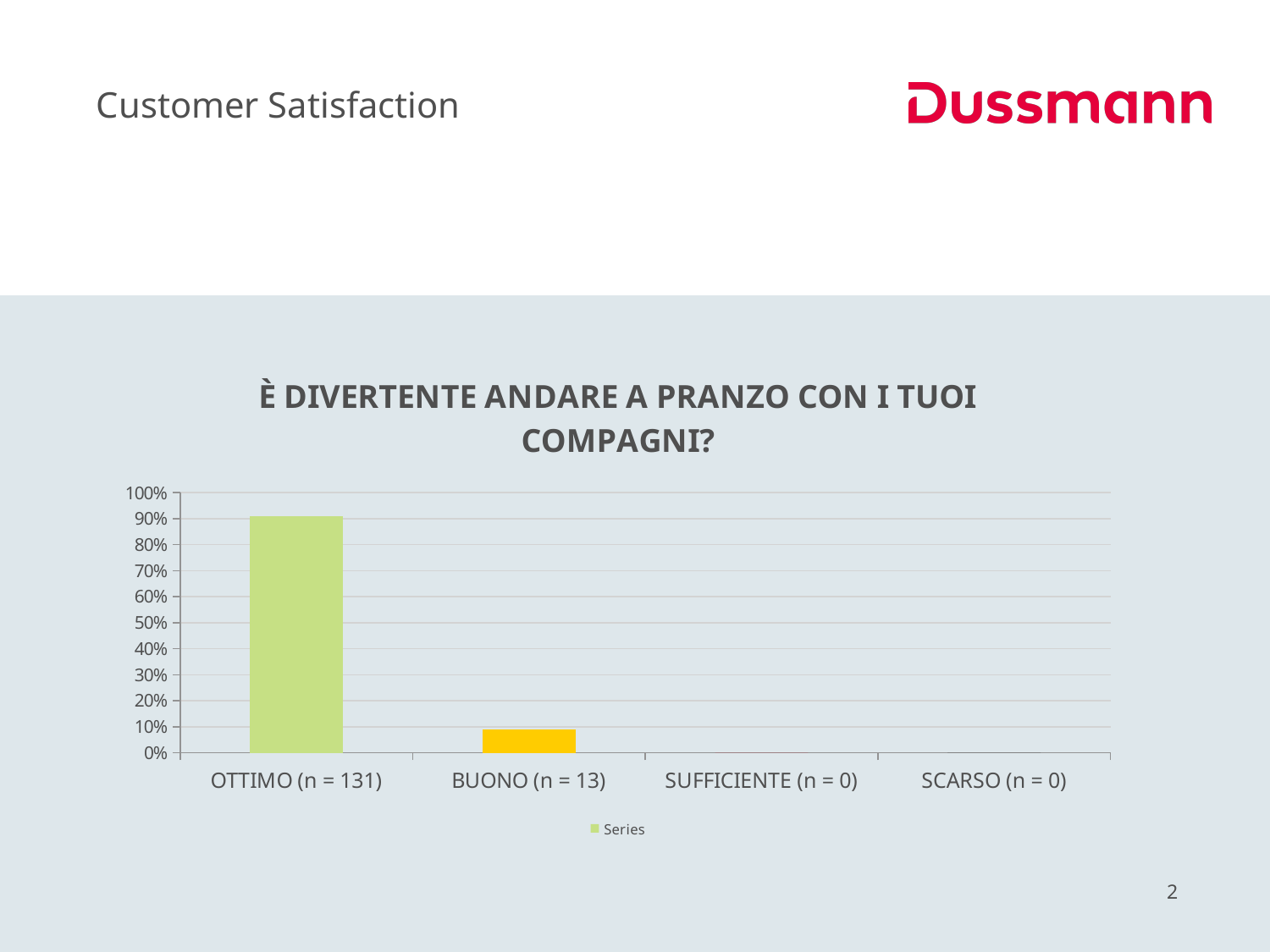
Which is larger, the value for BUONO (n = 13) or the value for SCARSO (n = 0)? BUONO (n = 13) What is the highest value shown on the y axis of the chart? 100% Which category has the highest value in the chart? OTTIMO (n = 131) Is the value for OTTIMO (n = 131) greater or less than 50%? greater Do the values rise or fall moving from left to right along the x axis? fall What kind of chart is shown on the slide? bar chart Which is larger, the value for OTTIMO (n = 131) or the value for BUONO (n = 13)? OTTIMO (n = 131) How many categories are shown on the x axis of the chart? 4 How many series does the chart legend list? 1 Is the value for OTTIMO (n = 131) greater or less than 80%? greater What is the title of the chart? È DIVERTENTE ANDARE A PRANZO CON I TUOI COMPAGNI? Is the value for BUONO (n = 13) greater or less than 20%? less